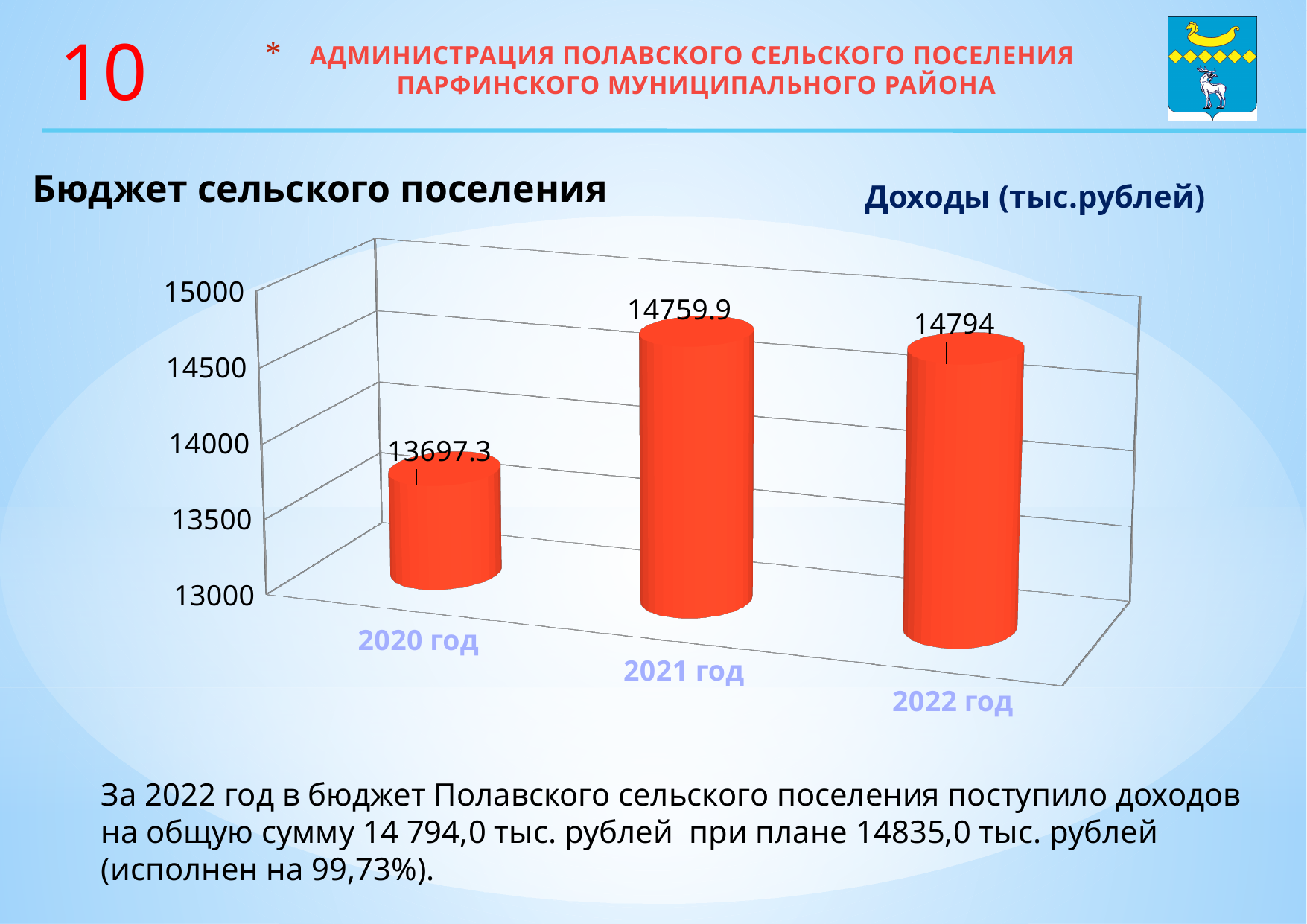
What kind of chart is shown? bar chart Is the value for 2020 год greater or less than 14000? less How many years are shown on the chart? 3 What is the value for 2022 год? 14794 Which year has the highest value? 2022 год What is the value for 2021 год? 14759.9 What is the difference between the values for 2022 год and 2020 год? 1096.7 Which is larger, the value for 2020 год or the value for 2021 год? 2021 год What is the difference between the values for 2021 год and 2020 год? 1062.6 What is the title of the chart? Доходы (тыс.рублей) What is the value for 2020 год? 13697.3 Which year has the lowest value? 2020 год